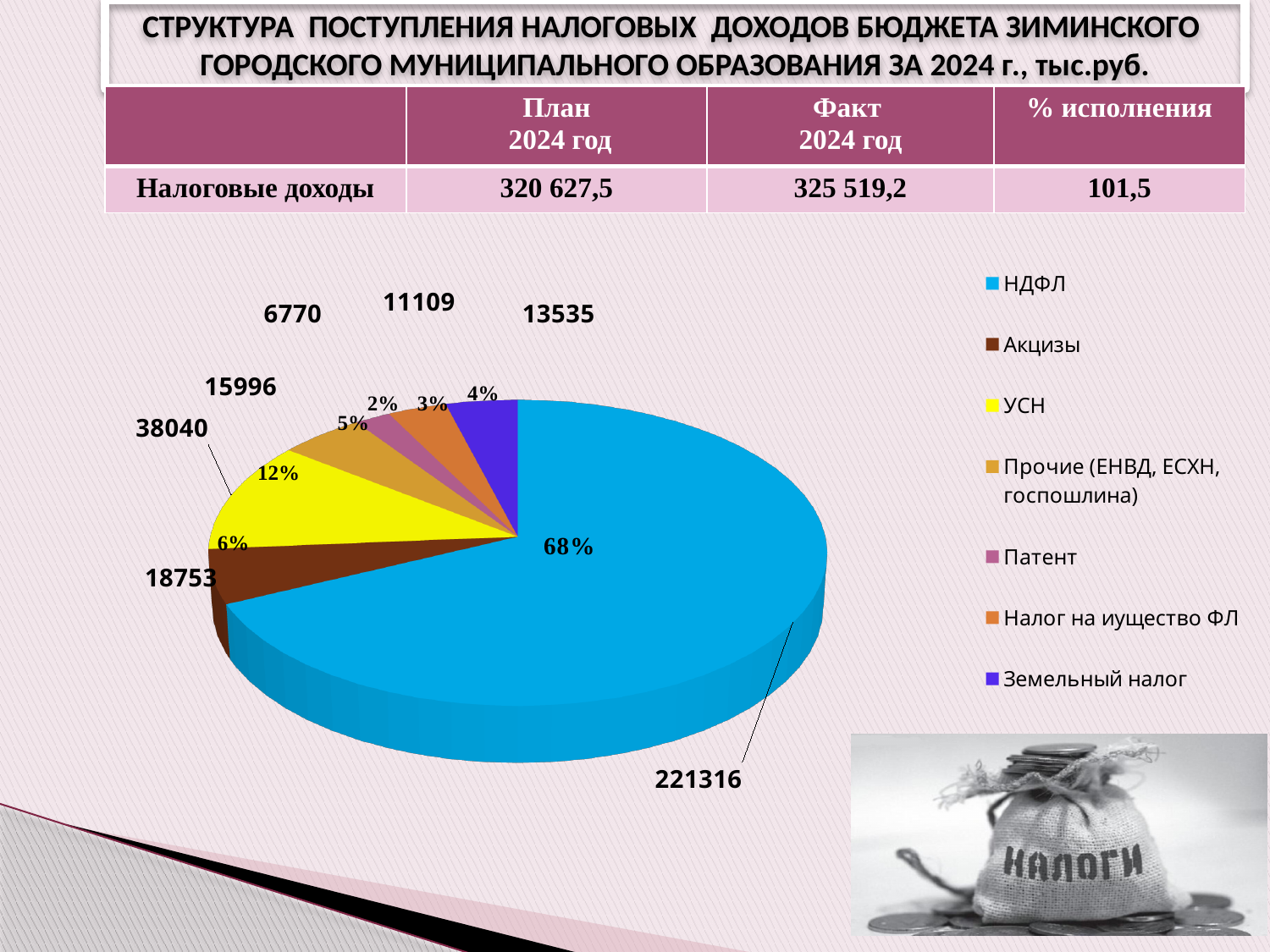
Which is larger in the pie chart, УСН or Акцизы? УСН What share of the pie does Акцизы account for? 6% How many slices does the pie chart have? 7 Which category has the largest slice in the pie chart? НДФЛ What share of the pie does НДФЛ account for? 68% What is the value shown for НДФЛ in the pie chart? 221316 Which category has the smallest slice in the pie chart? Патент What is the value shown for УСН in the pie chart? 38040 What kind of chart is shown on the slide? pie chart What share of the pie does УСН account for? 12% How many entries does the legend of the pie chart list? 7 What is the value shown for Акцизы in the pie chart? 18753